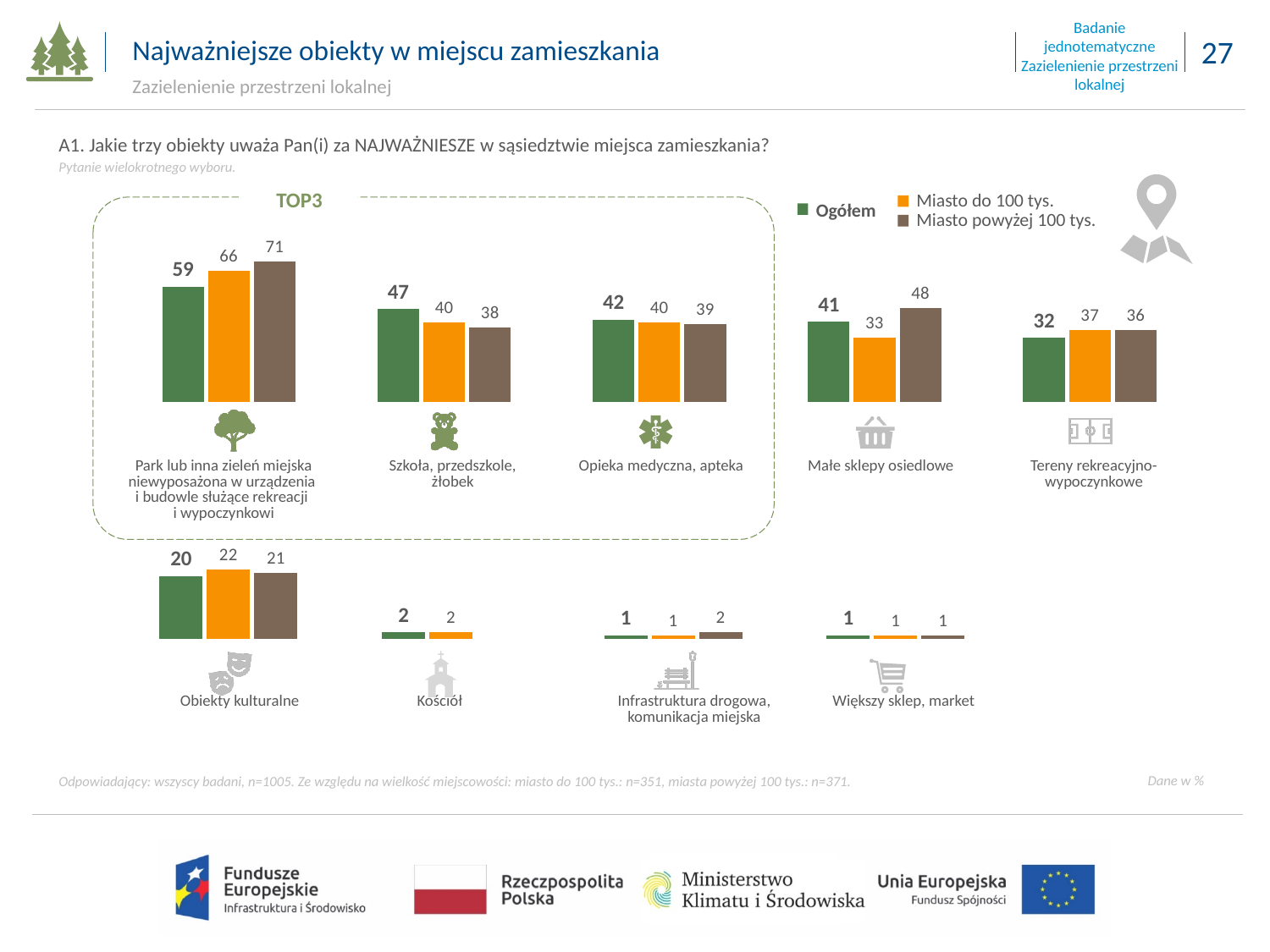
What is the Miasto powyżej 100 tys. value for Małe sklepy osiedlowe? 48 What is the Ogółem value for Obiekty kulturalne? 20 For Szkoła, przedszkole, żłobek, which is larger: the Ogółem value or the Miasto powyżej 100 tys. value? Ogółem How many categories are shown in the chart? 9 What is the difference between the Miasto powyżej 100 tys. and Miasto do 100 tys. values for Małe sklepy osiedlowe? 15 Which category has the highest Ogółem value? Park lub inna zieleń miejska niewyposażona w urządzenia i budowle służące rekreacji i wypoczynkowi What is the Ogółem value for Park lub inna zieleń miejska niewyposażona w urządzenia i budowle służące rekreacji i wypoczynkowi? 59 What kind of chart is shown on the slide? Bar chart What is the Miasto do 100 tys. value for Szkoła, przedszkole, żłobek? 40 Which colour represents the Miasto do 100 tys. series? Orange How many series does the legend list? 3 Which category has the lowest Miasto do 100 tys. value? Infrastruktura drogowa, komunikacja miejska and Większy sklep, market (both 1)